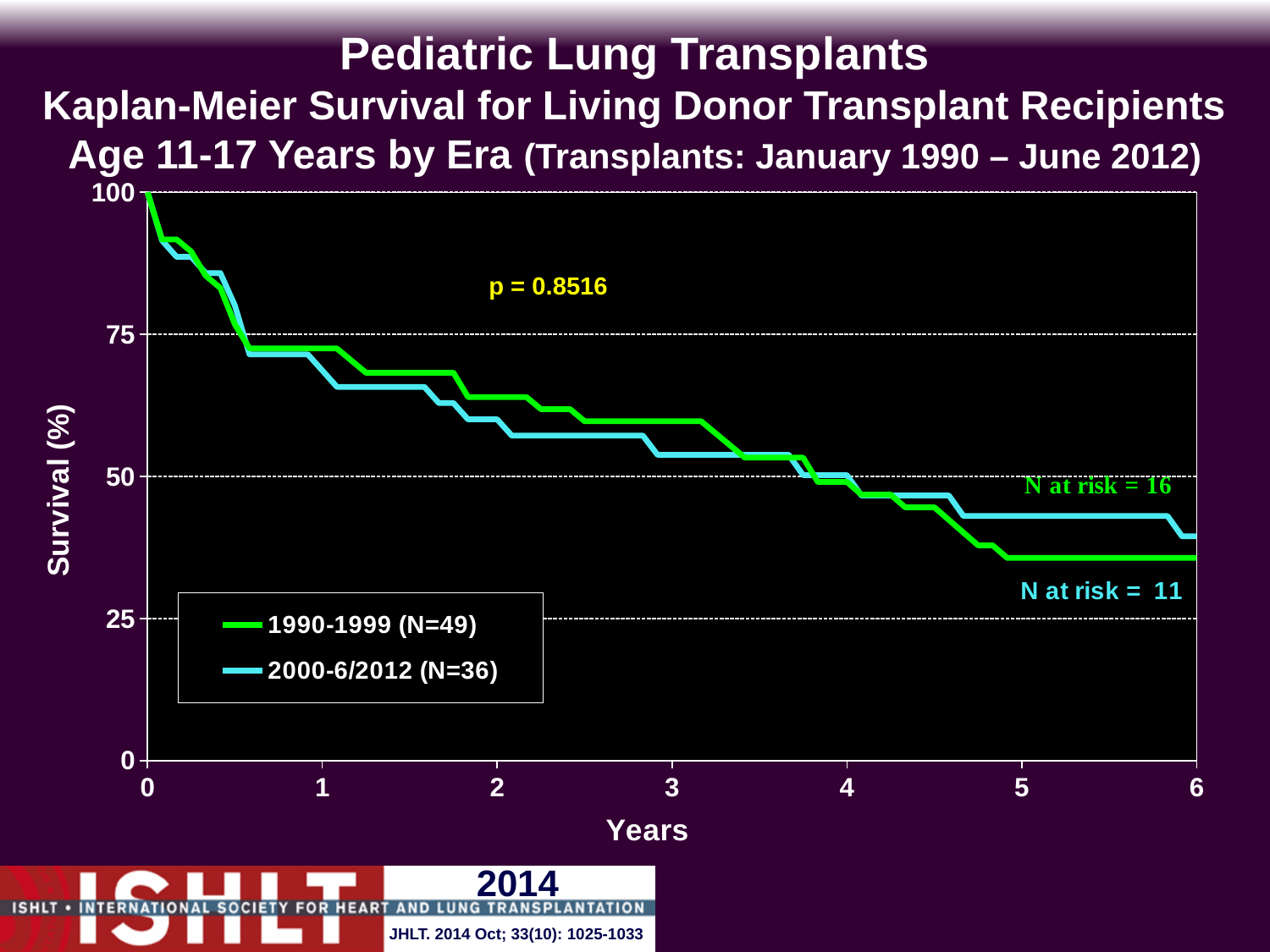
Is the survival value for the 2000-6/2012 series at 1 year greater or less than 50? greater What is the p-value printed on the chart? p = 0.8516 Do the survival curves rise or fall as years increase along the x axis? fall At 5 years, which series has the higher survival, 1990-1999 or 2000-6/2012? 2000-6/2012 What is the N for the 2000-6/2012 era shown in the legend? N=36 What is the N for the 1990-1999 era shown in the legend? N=49 How many series does the legend list? 2 What is the N at risk printed in cyan for the 2000-6/2012 series? 11 What is the N at risk printed in green for the 1990-1999 series? 16 Is the survival value for the 1990-1999 series at 5 years greater or less than 50? less What is the label of the y axis? Survival (%) What kind of chart is shown on the slide? line chart